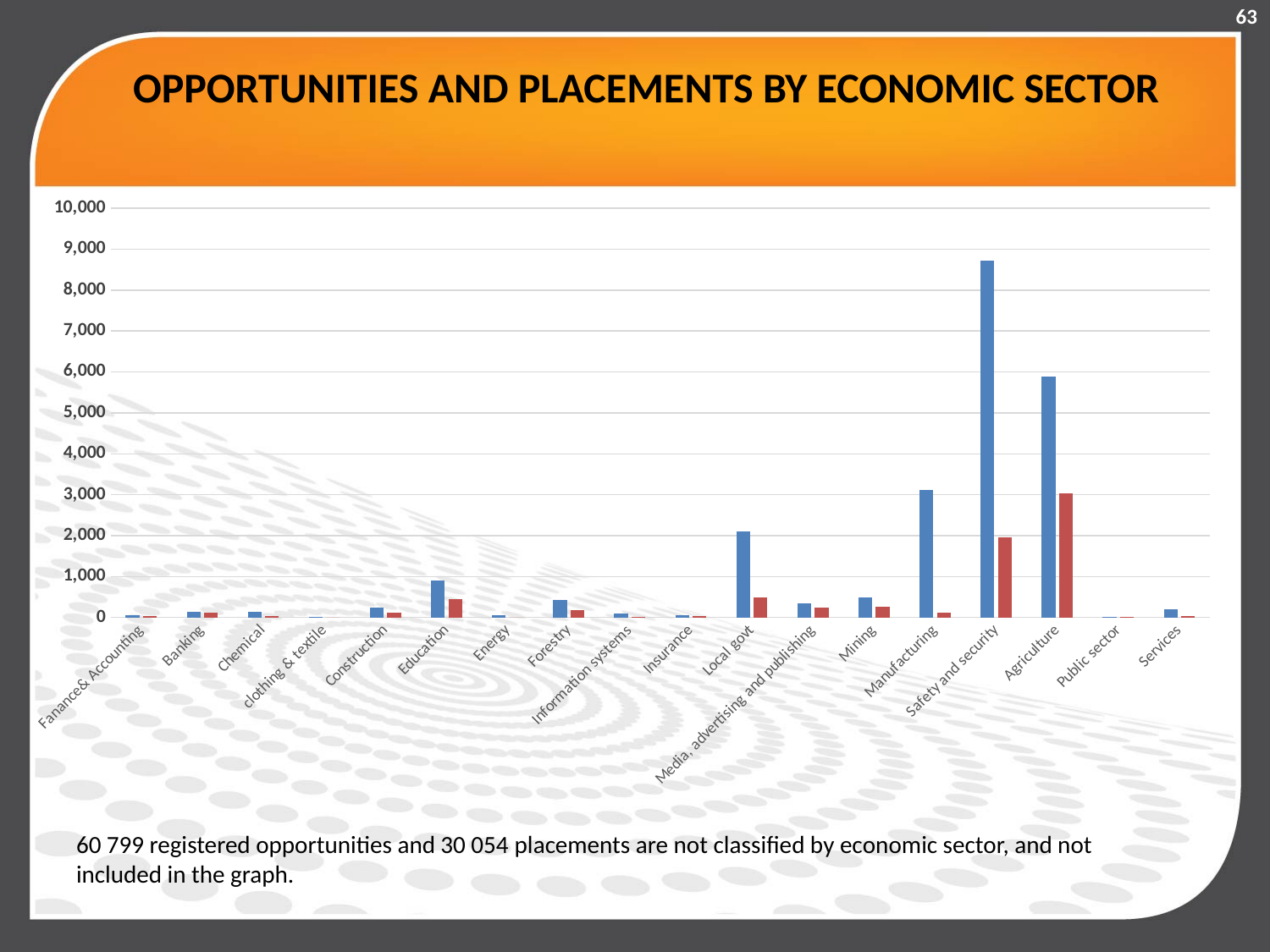
Is the blue bar for Manufacturing greater or less than 2,000? greater What is the title of the chart? OPPORTUNITIES AND PLACEMENTS BY ECONOMIC SECTOR How many economic sector categories are shown on the x axis of the chart? 18 Is the blue bar for Safety and security greater or less than 8,000? greater Which economic sector has the tallest red bar? Agriculture Which has the larger blue bar, Safety and security or Agriculture? Safety and security Which has the larger blue bar, Manufacturing or Local govt? Manufacturing What kind of chart is shown on the slide? bar chart Is the blue bar for Education greater or less than 1,000? less Which economic sector has the tallest blue bar? Safety and security